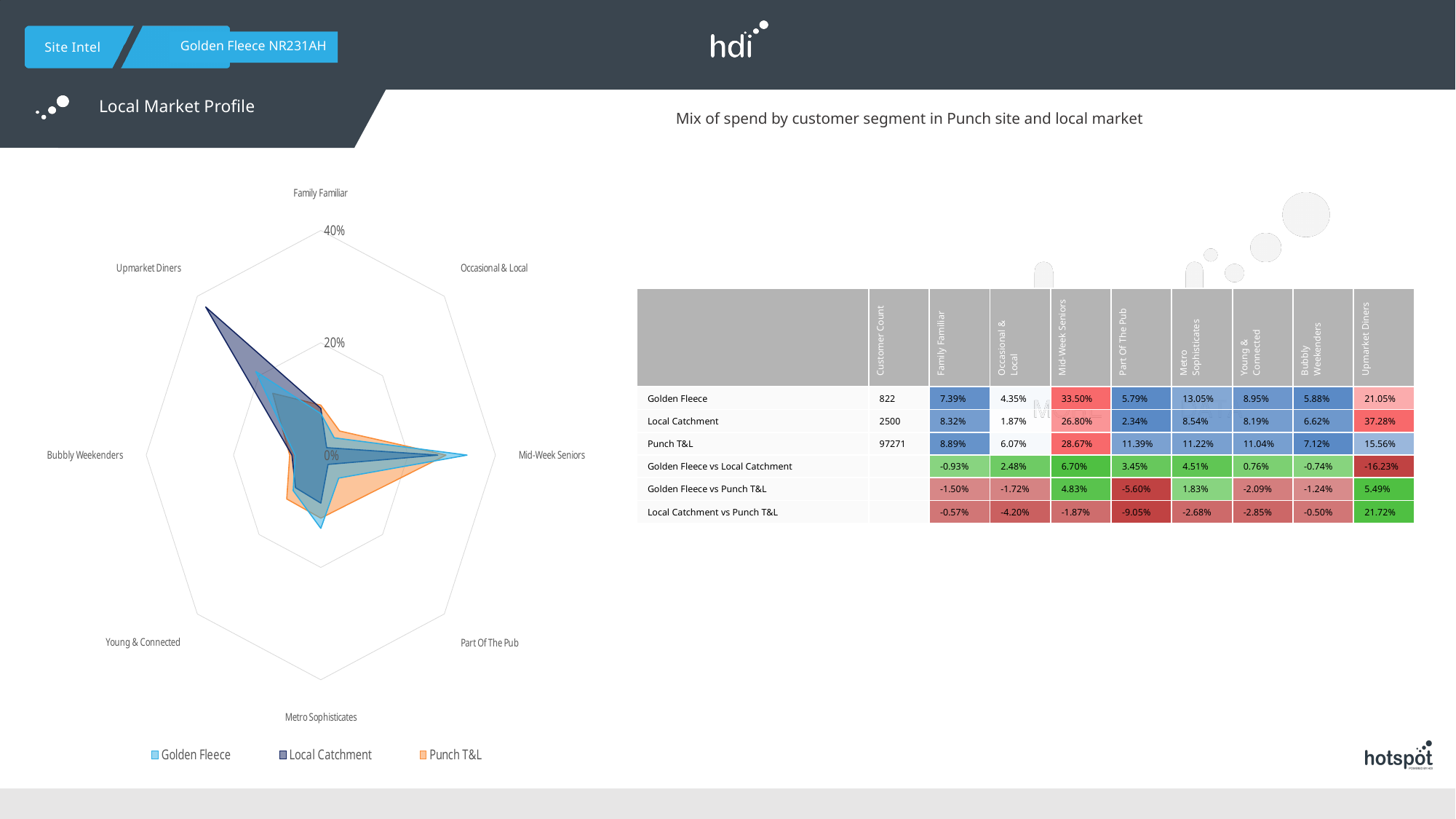
Which series are listed in the radar chart's legend? Golden Fleece, Local Catchment, Punch T&L What is the Golden Fleece value for Mid-Week Seniors, as shown in the table? 33.50% How many customer segments (axes) does the radar chart have? 8 What kind of chart is shown on the left of the slide? Radar chart Is the Punch T&L value for Part Of The Pub greater or less than 20%? less Which customer segment has the lowest value for Golden Fleece? Occasional & Local Which customer segment has the highest value for Local Catchment? Upmarket Diners How many series does the radar chart's legend list? 3 What is the highest percentage tick shown on the radar chart's axis? 40% Is the Local Catchment value for Upmarket Diners greater or less than 20%? greater For Mid-Week Seniors, which is larger: Golden Fleece or Local Catchment? Golden Fleece Which customer segment has the highest value for Golden Fleece? Mid-Week Seniors